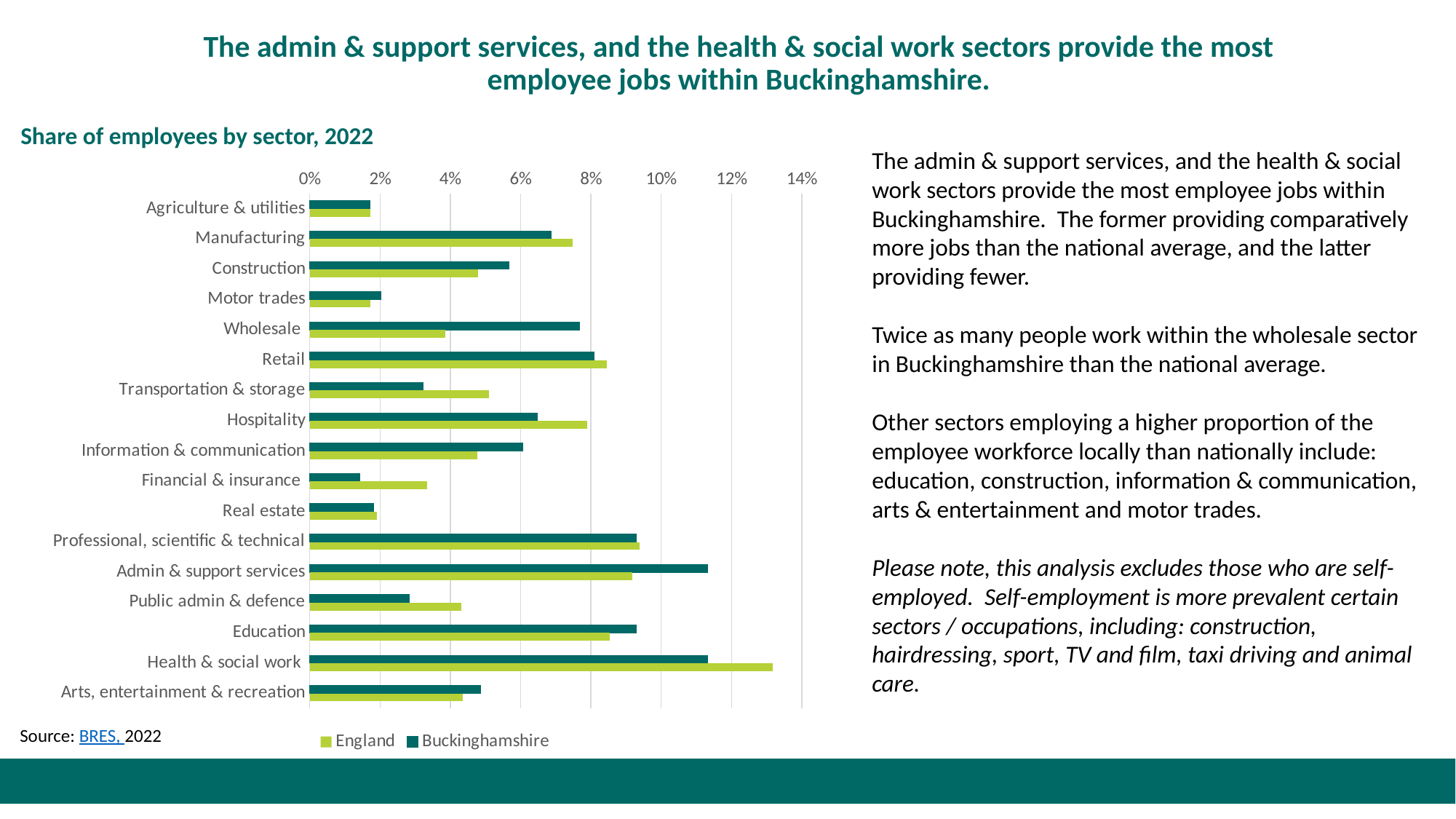
For the Wholesale sector, which is larger: the England value or the Buckinghamshire value? Buckinghamshire How many sectors are listed on the chart? 17 How many series does the chart legend list? 2 Is the England value for Health & social work greater or less than 12%? greater Is the Buckinghamshire value for Financial & insurance greater or less than 2%? less What kind of chart is shown on the slide? bar chart What is the title of the chart? Share of employees by sector, 2022 Which sector has the highest share of employees for England? Health & social work For the Health & social work sector, which is larger: the England value or the Buckinghamshire value? England Which series is shown in light green in the chart? England Is the Buckinghamshire value for Wholesale greater or less than 6%? greater For the Public admin & defence sector, which is larger: the England value or the Buckinghamshire value? England